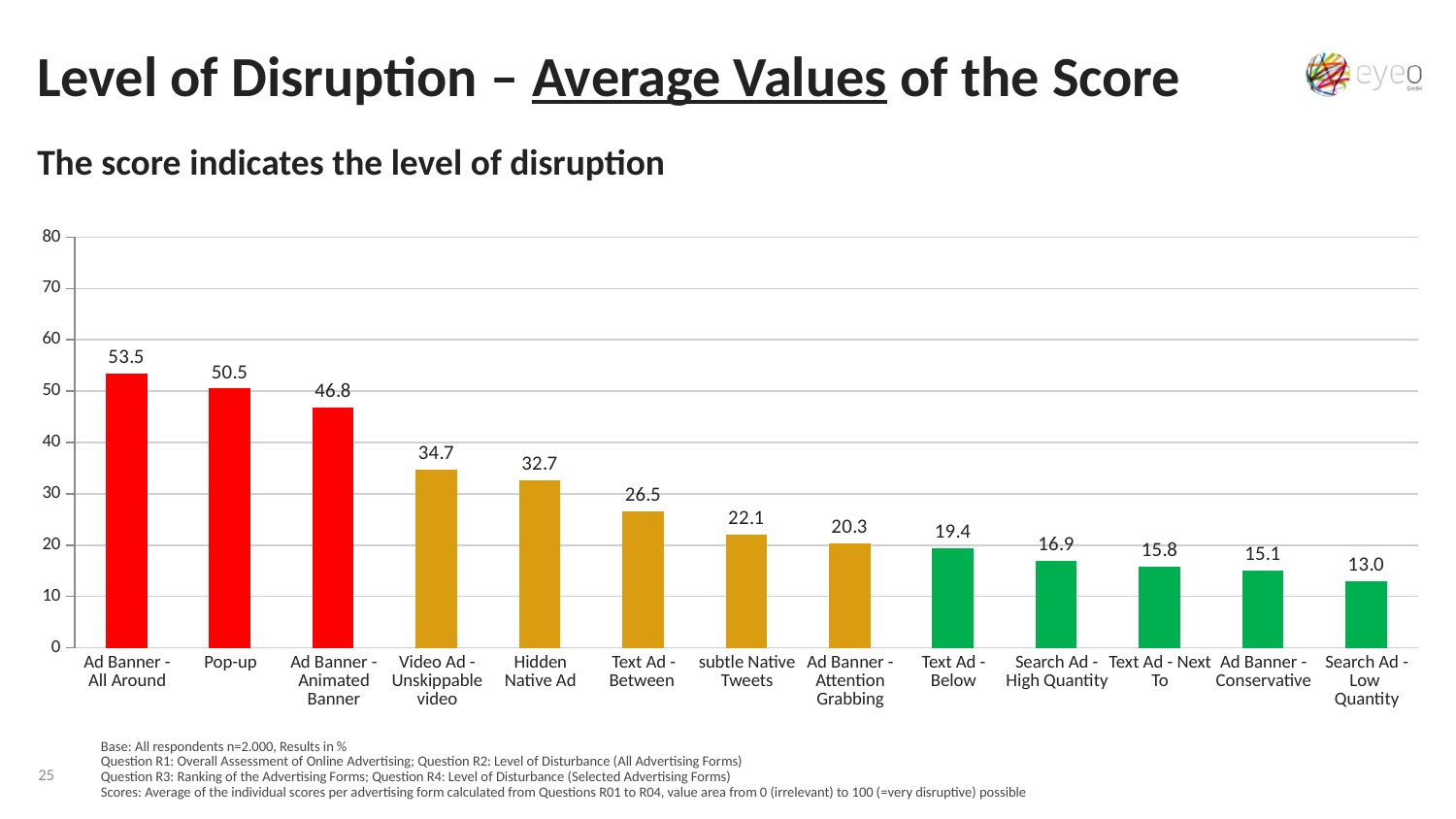
Is the value for Ad Banner - Animated Banner greater or less than 40? greater Which advertising form has the highest average disruption score? Ad Banner - All Around What is the value shown for Hidden Native Ad? 32.7 What is the average disruption score for Pop-up? 50.5 Which has a higher score, Text Ad - Below or Ad Banner - Conservative? Text Ad - Below What is the value shown for Search Ad - High Quantity? 16.9 Which advertising form has the lowest average disruption score? Search Ad - Low Quantity Do the values rise or fall from left to right along the x axis? Fall What kind of chart is shown on the slide? Bar chart What is the difference between the scores for Video Ad - Unskippable video and Text Ad - Between? 8.2 How many advertising forms are shown on the chart? 13 What is the difference between the scores for Ad Banner - All Around and Pop-up? 3.0